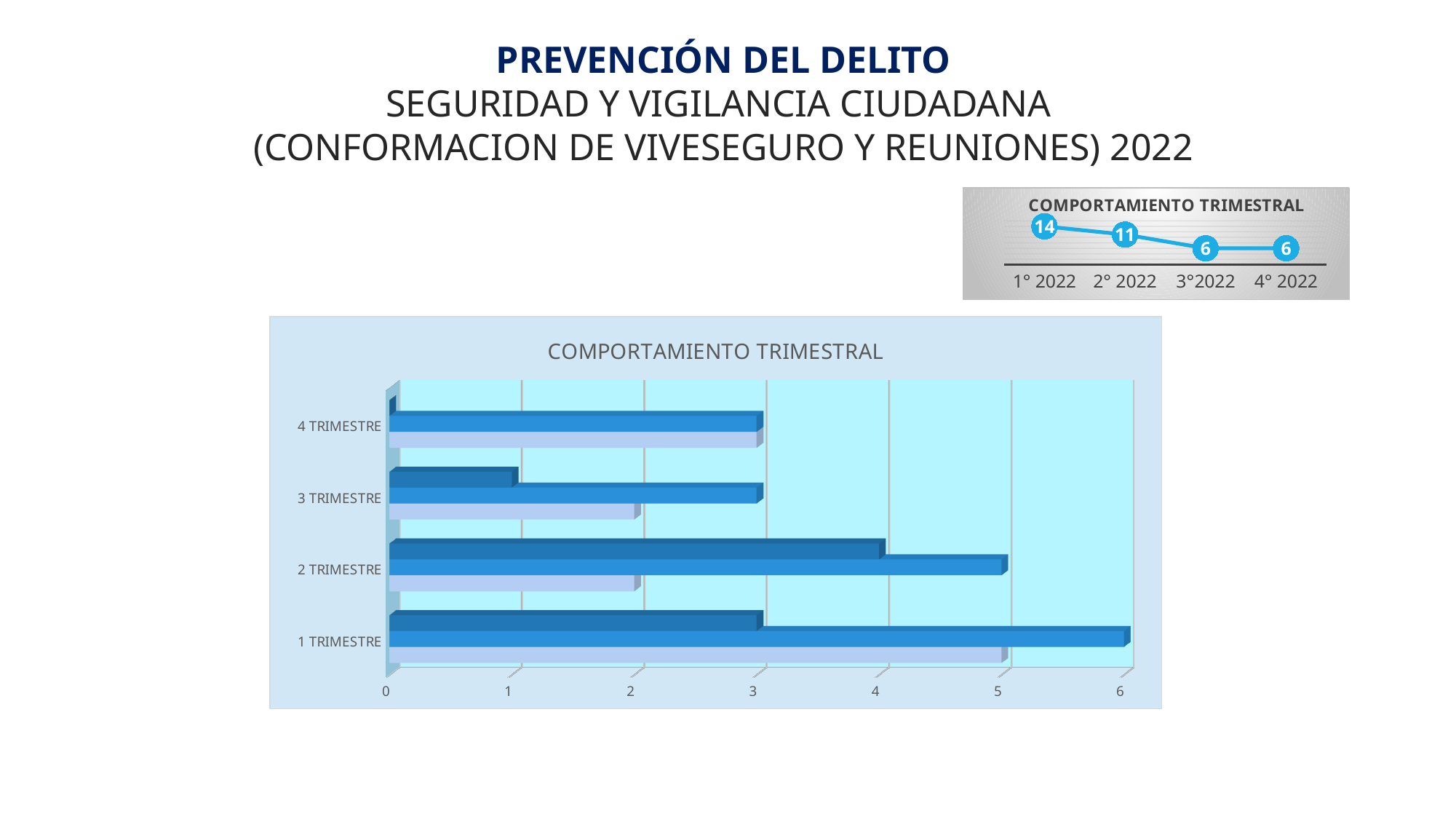
In the line chart at the top right, do the values rise or fall from 1° 2022 to 4° 2022? fall In the line chart at the top right, what is the value for 1° 2022? 14 In the line chart at the top right, what is the difference between the values for 1° 2022 and 2° 2022? 3 How many categories are shown on the vertical axis of the large bar chart? 4 How many data points are plotted in the line chart at the top right? 4 What kind of chart is the large chart in the lower part of the slide? bar chart What kind of chart is the small chart at the top right of the slide? line chart In the large bar chart, which category contains the longest bar? 1 TRIMESTRE In the line chart at the top right, what is the value for 3°2022? 6 In the line chart at the top right, which is larger, the value for 2° 2022 or the value for 4° 2022? 2° 2022 In the line chart at the top right, which quarter has the highest value? 1° 2022 In the line chart at the top right, what is the value for 2° 2022? 11